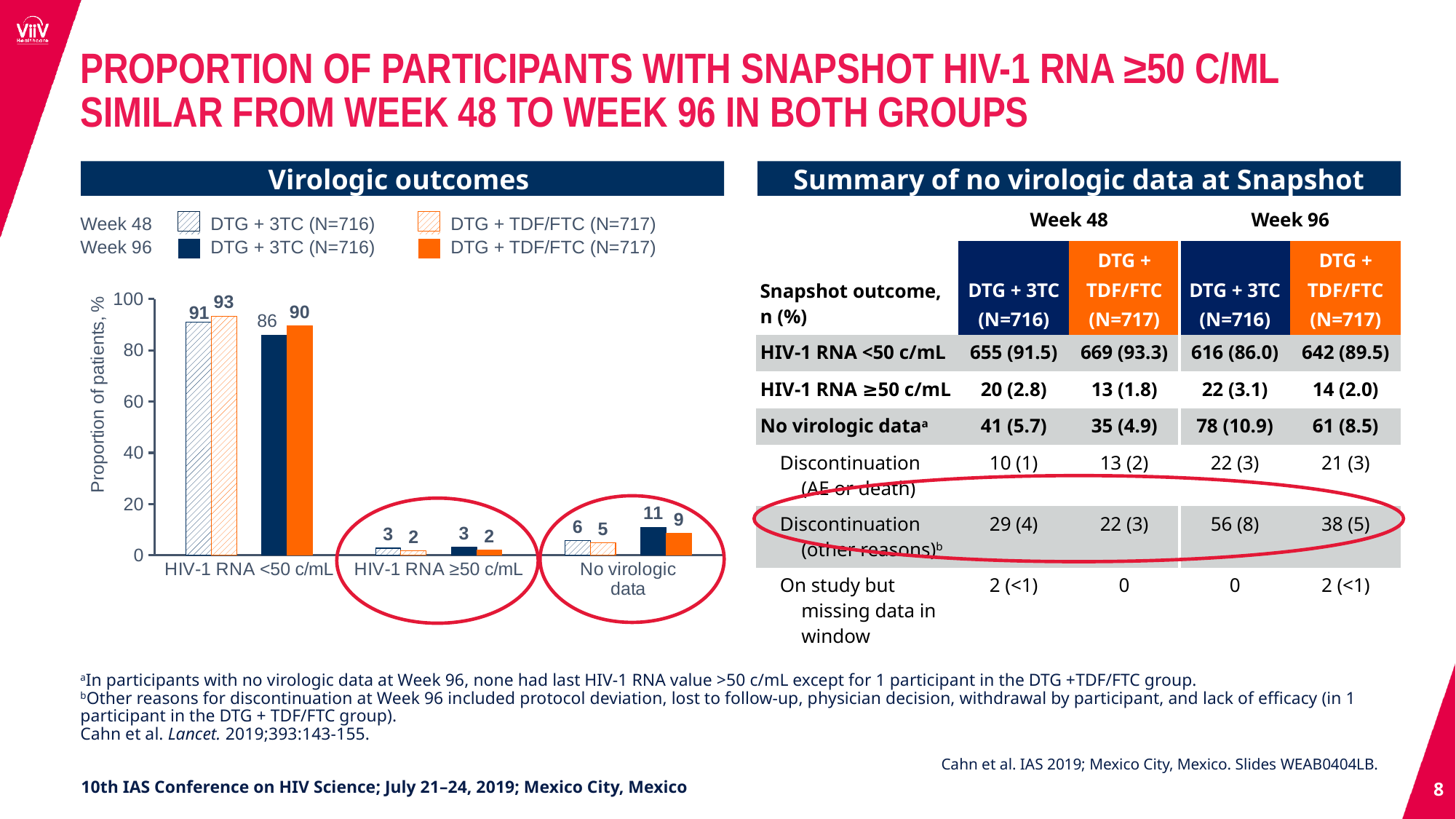
In the Virologic outcomes chart, which is larger in the No virologic data category at Week 96: DTG + 3TC (N=716) or DTG + TDF/FTC (N=717)? DTG + 3TC (N=716) How many categories are shown on the x axis of the Virologic outcomes chart? 3 What kind of chart is shown under "Virologic outcomes"? bar chart In the Virologic outcomes chart, what is the Week 48 value for DTG + 3TC (N=716) in the HIV-1 RNA <50 c/mL category? 91 What is the y-axis label of the Virologic outcomes chart? Proportion of patients, % In the Virologic outcomes chart, is the Week 96 value for DTG + 3TC (N=716) in the HIV-1 RNA <50 c/mL category greater or less than 80? greater In the Virologic outcomes chart, what is the Week 96 value for DTG + 3TC (N=716) in the No virologic data category? 11 How many series does the legend of the Virologic outcomes chart list? 4 In the Virologic outcomes chart, what is the Week 48 value for DTG + TDF/FTC (N=717) in the HIV-1 RNA ≥50 c/mL category? 2 In the Virologic outcomes chart, which category has the highest bars? HIV-1 RNA <50 c/mL In the Virologic outcomes chart, what is the Week 96 value for DTG + TDF/FTC (N=717) in the HIV-1 RNA <50 c/mL category? 90 In the Virologic outcomes chart, what is the difference between the Week 48 and Week 96 values for DTG + 3TC (N=716) in the HIV-1 RNA <50 c/mL category? 5